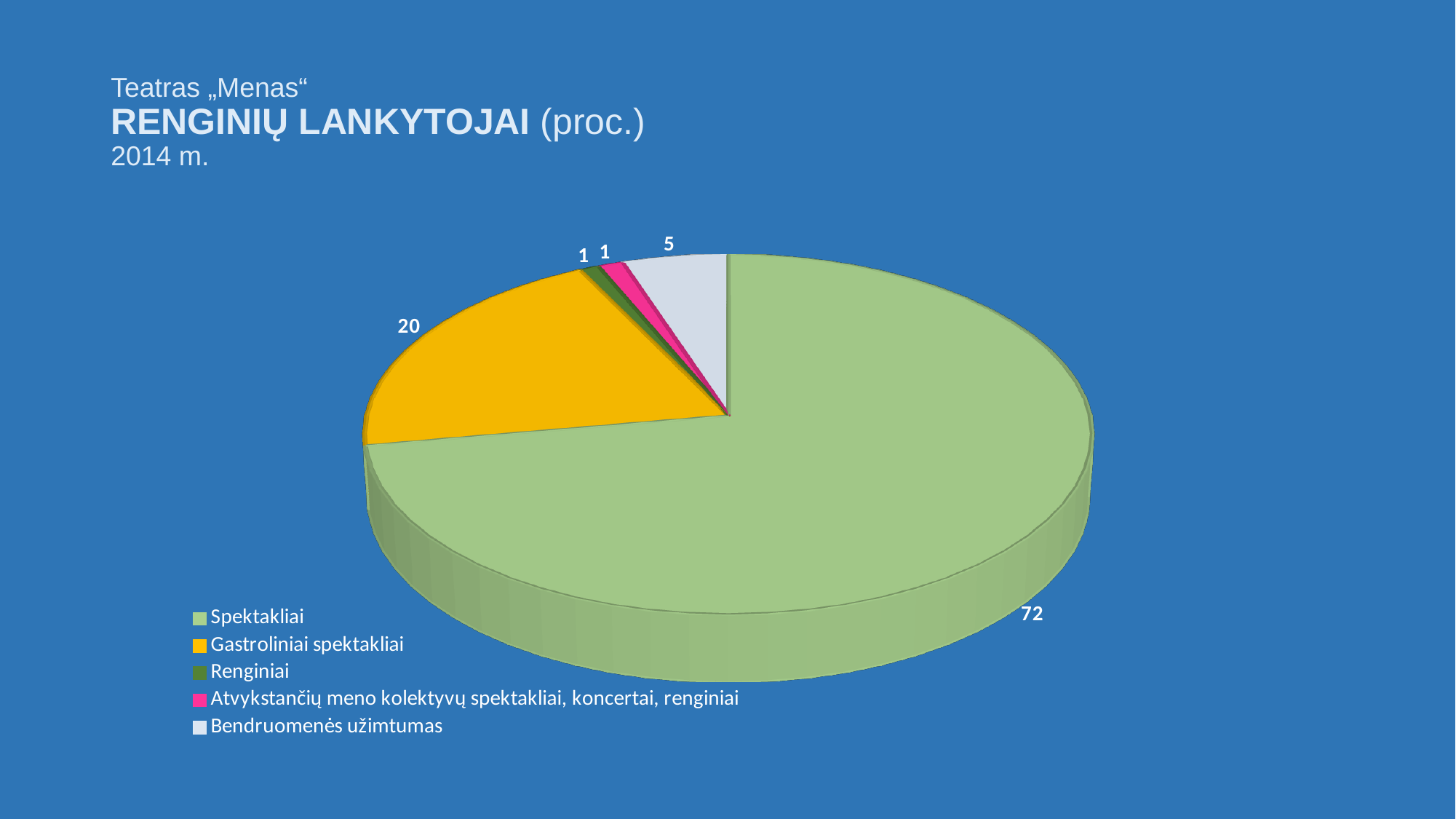
Which year does the chart title refer to? 2014 m. What share of the pie does the Spektakliai slice represent, according to its data label? 72 Which category has the largest slice of the pie? Spektakliai What kind of chart is shown on the slide? Pie chart What value is shown for the Bendruomenės užimtumas slice? 5 Which is larger, the value for Bendruomenės užimtumas or the value for Renginiai? Bendruomenės užimtumas What value is shown for the Spektakliai slice? 72 What value is shown for the Renginiai slice? 1 What value is shown for the Gastroliniai spektakliai slice? 20 How many categories does the pie chart show? 5 What is the difference between the values for Gastroliniai spektakliai and Bendruomenės užimtumas? 15 What is the difference between the values for Spektakliai and Gastroliniai spektakliai? 52